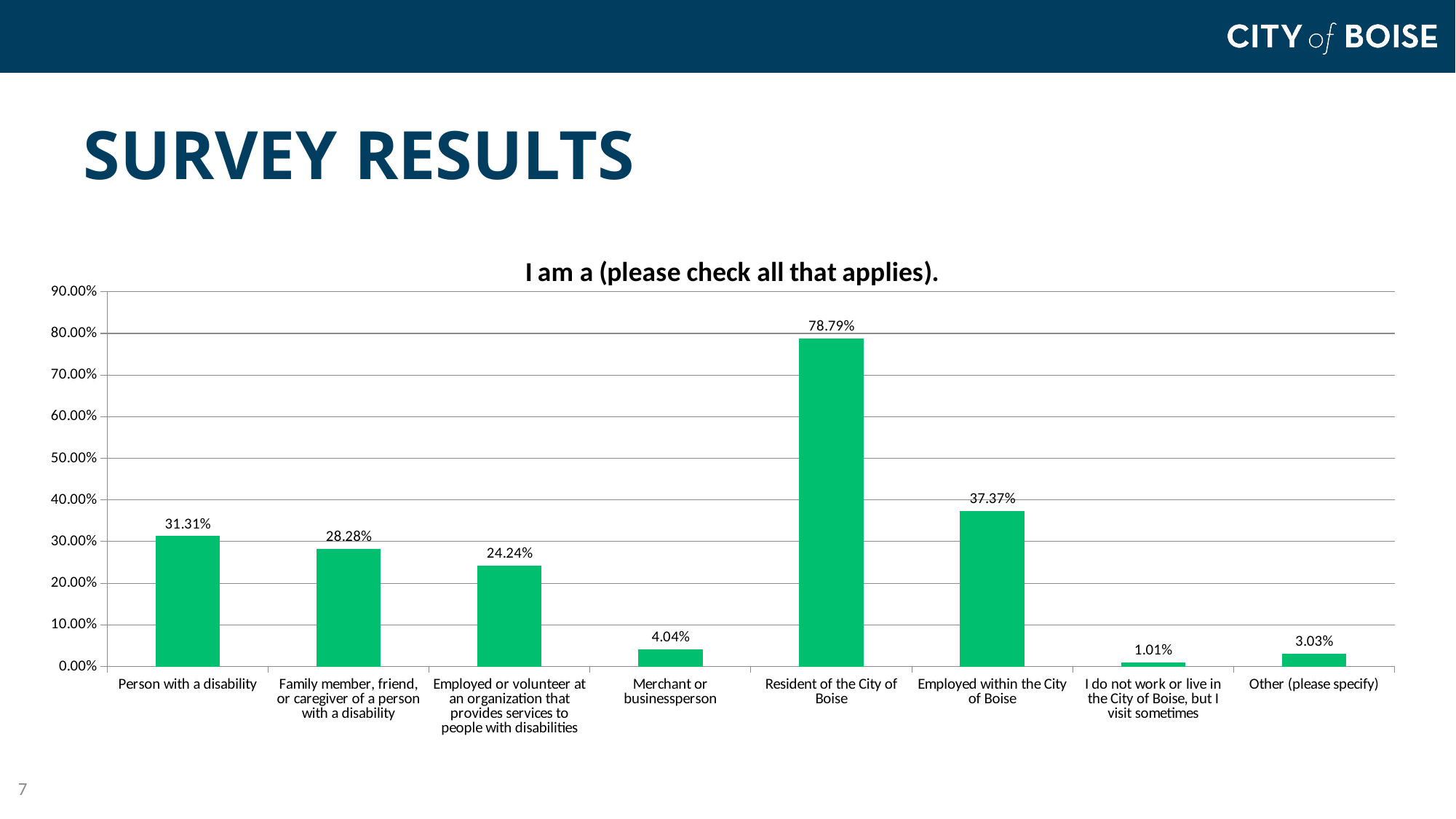
What is the difference between 'Resident of the City of Boise' and 'Employed within the City of Boise'? 41.42% What type of chart is shown on the slide? Bar chart What percentage of respondents selected 'Merchant or businessperson'? 4.04% Which category has the highest value? Resident of the City of Boise What percentage of respondents identified as a person with a disability? 31.31% What is the value for 'Resident of the City of Boise'? 78.79% Which is larger: 'Person with a disability' or 'Family member, friend, or caregiver of a person with a disability'? Person with a disability Is the value for 'Employed within the City of Boise' greater or less than 30.00%? greater Which category has the lowest value? I do not work or live in the City of Boise, but I visit sometimes What is the value for 'Other (please specify)'? 3.03% How many categories are shown in the chart? 8 What is the title of the chart? I am a (please check all that applies).